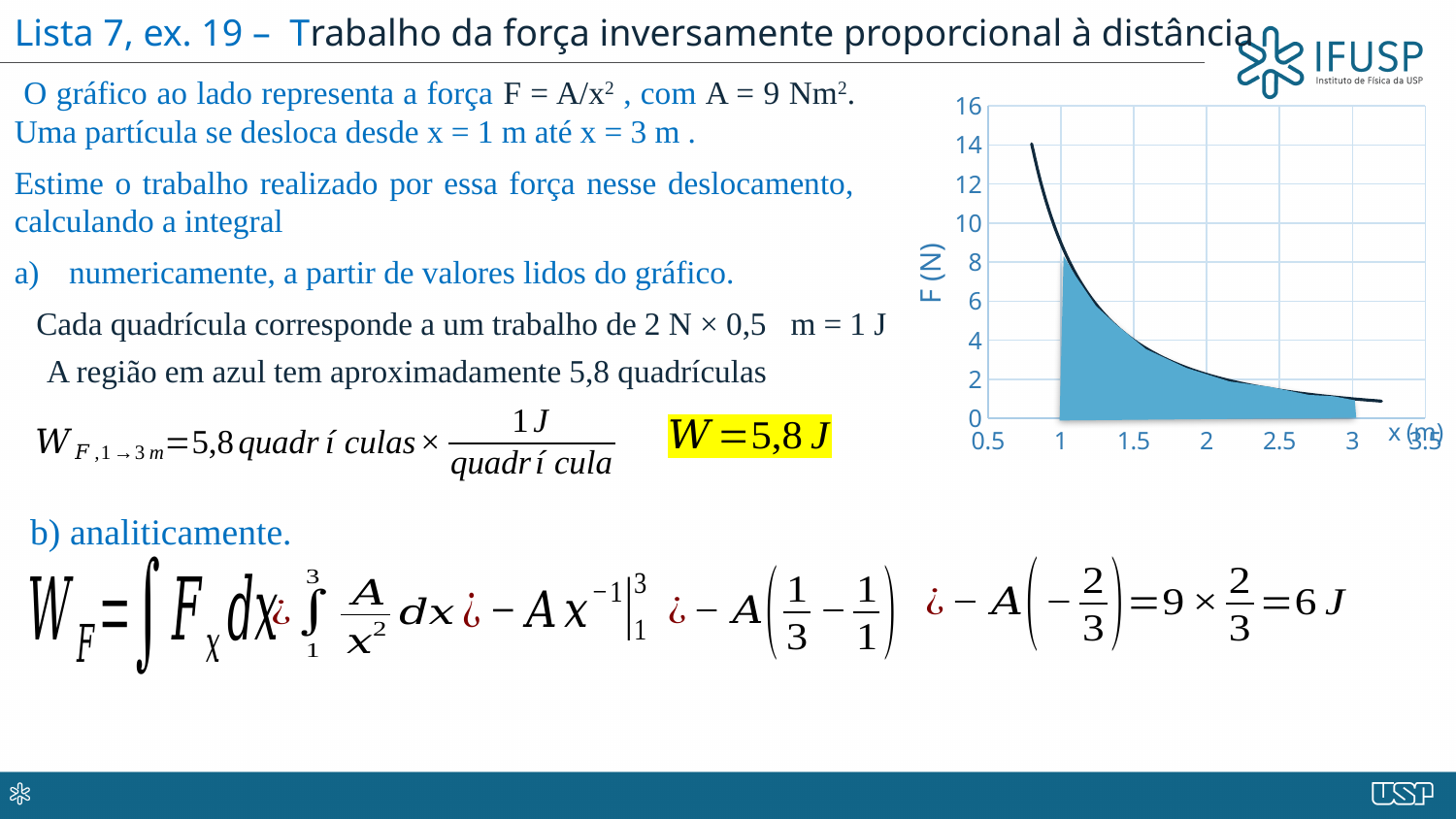
At which x value does the blue shaded region begin? 1 What kind of chart is shown on the slide? line chart What is the highest tick value shown on the vertical axis? 16 Is the value of F at x = 1 greater or less than 6? greater What is the label of the vertical axis of the chart? F (N) Is the value of F at x = 2 greater or less than 4? less How many tick marks are labelled on the horizontal axis? 7 Does the force F rise or fall as x increases along the x axis? fall Is the value of F at x = 1.5 greater or less than 6? less At which x value does the blue shaded region end? 3 What is the label of the horizontal axis of the chart? x (m)